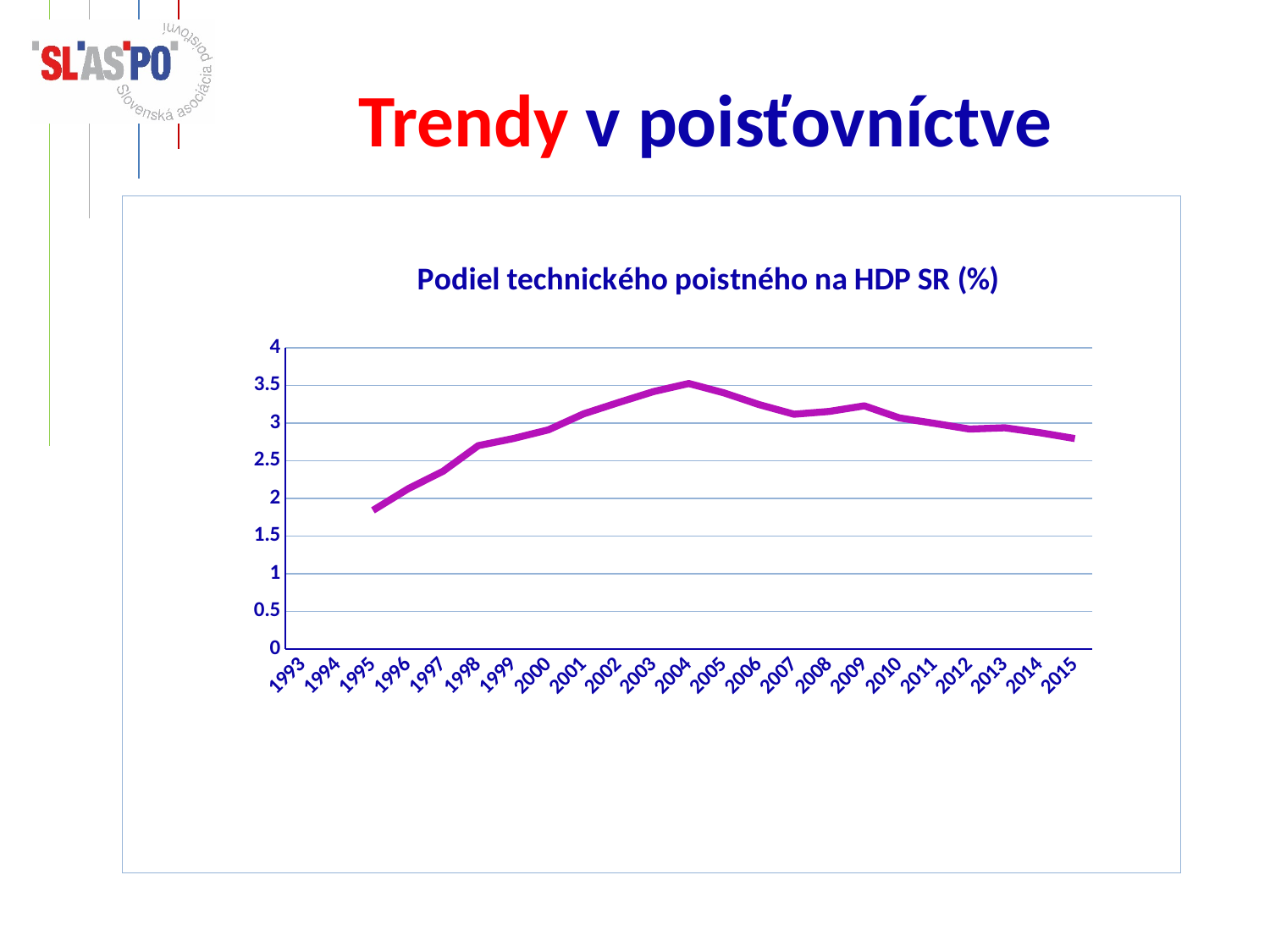
Which year has the larger value, 2004 or 2015? 2004 Is the value for 2015 greater or less than 3? less What kind of chart is shown on the slide? line chart Is the value for 1998 greater or less than 2.5? greater In which year does the line have its lowest value? 1995 Does the line rise or fall between 1995 and 2004? rise Is the value for 1995 greater or less than 2? less What is the title of the chart? Podiel technického poistného na HDP SR (%) Which year has the larger value, 1995 or 2009? 2009 In which year does the line reach its highest value? 2004 How many year labels are shown on the x axis? 23